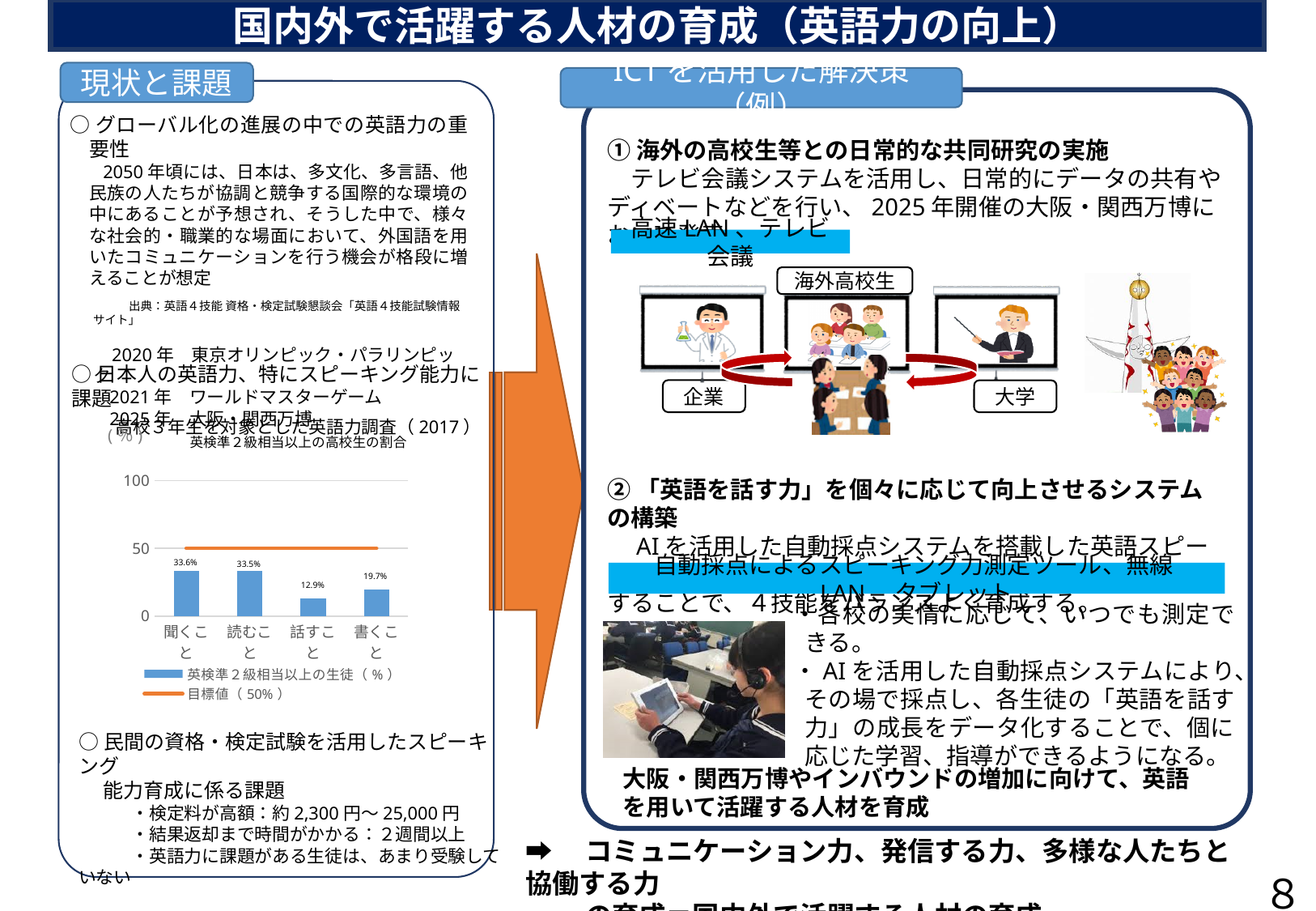
What is the value for 聞くこと in the bar chart? 33.6% What is the value for 話すこと in the bar chart? 12.9% What is the value for 書くこと in the bar chart? 19.7% Which category has the lowest value in the bar chart? 話すこと What is the value for 読むこと in the bar chart? 33.5% Is the value for 聞くこと in the bar chart greater or less than 50? less How many categories are shown on the x axis of the bar chart? 4 Which is larger in the bar chart, the value for 聞くこと or the value for 話すこと? 聞くこと What is the difference between the values for 書くこと and 話すこと in the bar chart? 6.8% What target value does the orange line in the chart represent, according to the legend? 目標値（50%） What kind of chart is shown on the slide? bar chart How many series does the legend of the chart list? 2